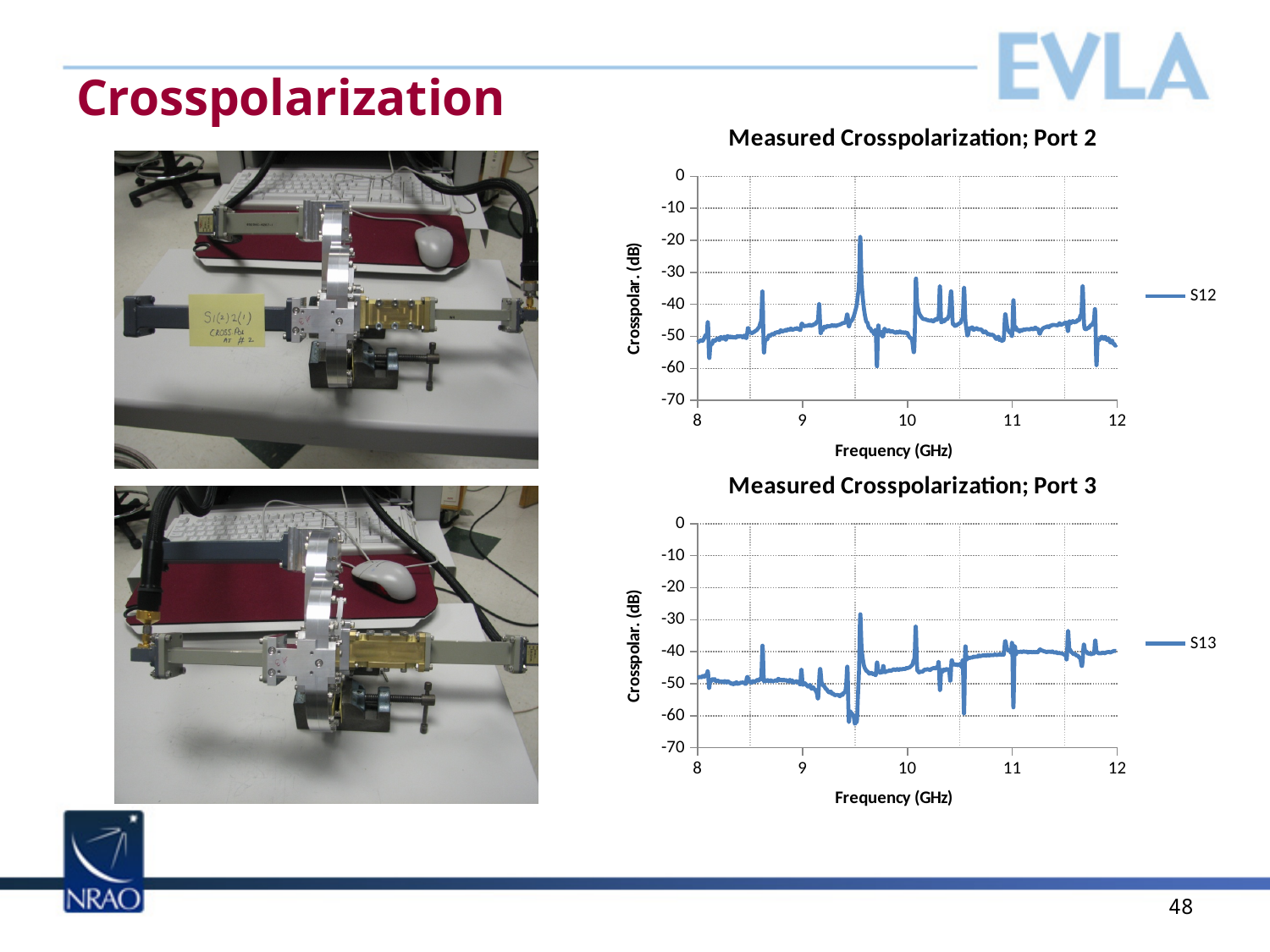
What kind of chart is "Measured Crosspolarization; Port 2"? line chart How many series does the legend of "Measured Crosspolarization; Port 3" list? 1 What is the x-axis label of "Measured Crosspolarization; Port 3"? Frequency (GHz) In "Measured Crosspolarization; Port 2", is the highest peak of S12 (near 9.6 GHz) greater or less than -30? greater What kind of chart is "Measured Crosspolarization; Port 3"? line chart In "Measured Crosspolarization; Port 2", is the S12 value at 8 GHz greater or less than -40? less How many charts are shown on the slide? 2 What is the name of the series plotted in "Measured Crosspolarization; Port 2"? S12 In "Measured Crosspolarization; Port 3", does the S13 level overall rise or fall from 8 GHz to 12 GHz? rise In "Measured Crosspolarization; Port 3", is the S13 value at 8 GHz greater or less than -40? less How many series does the legend of "Measured Crosspolarization; Port 2" list? 1